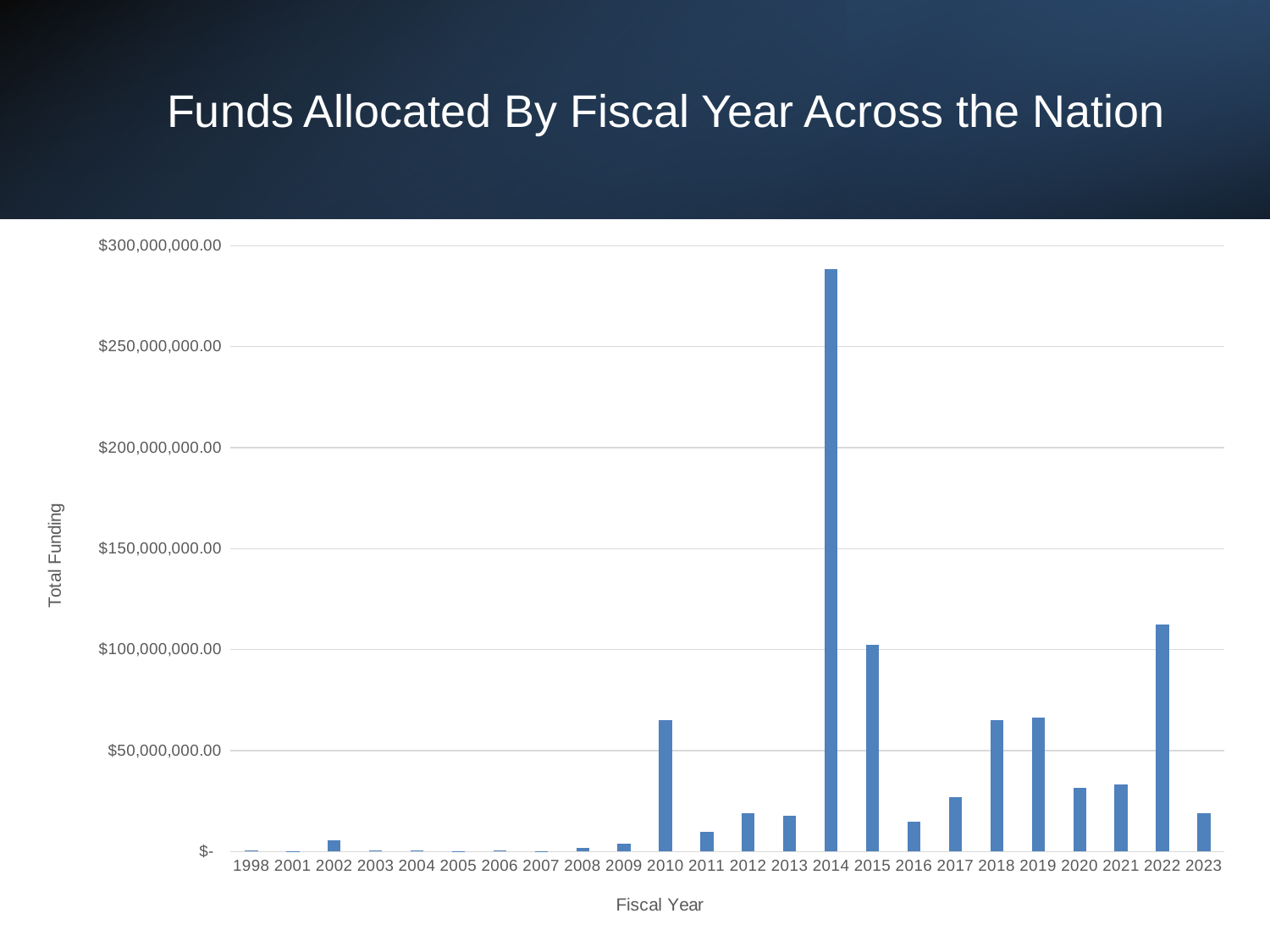
What is the label on the vertical axis of the chart? Total Funding Is the value for 2023 greater or less than $50,000,000.00? less How many fiscal years are shown on the x axis of the chart? 24 Which fiscal year has the larger total funding, 2019 or 2022? 2022 Is the value for 2022 greater or less than $100,000,000.00? greater Which fiscal year has the larger total funding, 2014 or 2015? 2014 Is the value for 2017 greater or less than $50,000,000.00? less What is the title of the chart? Funds Allocated By Fiscal Year Across the Nation What kind of chart is shown on the slide? bar chart Which fiscal year has the highest total funding? 2014